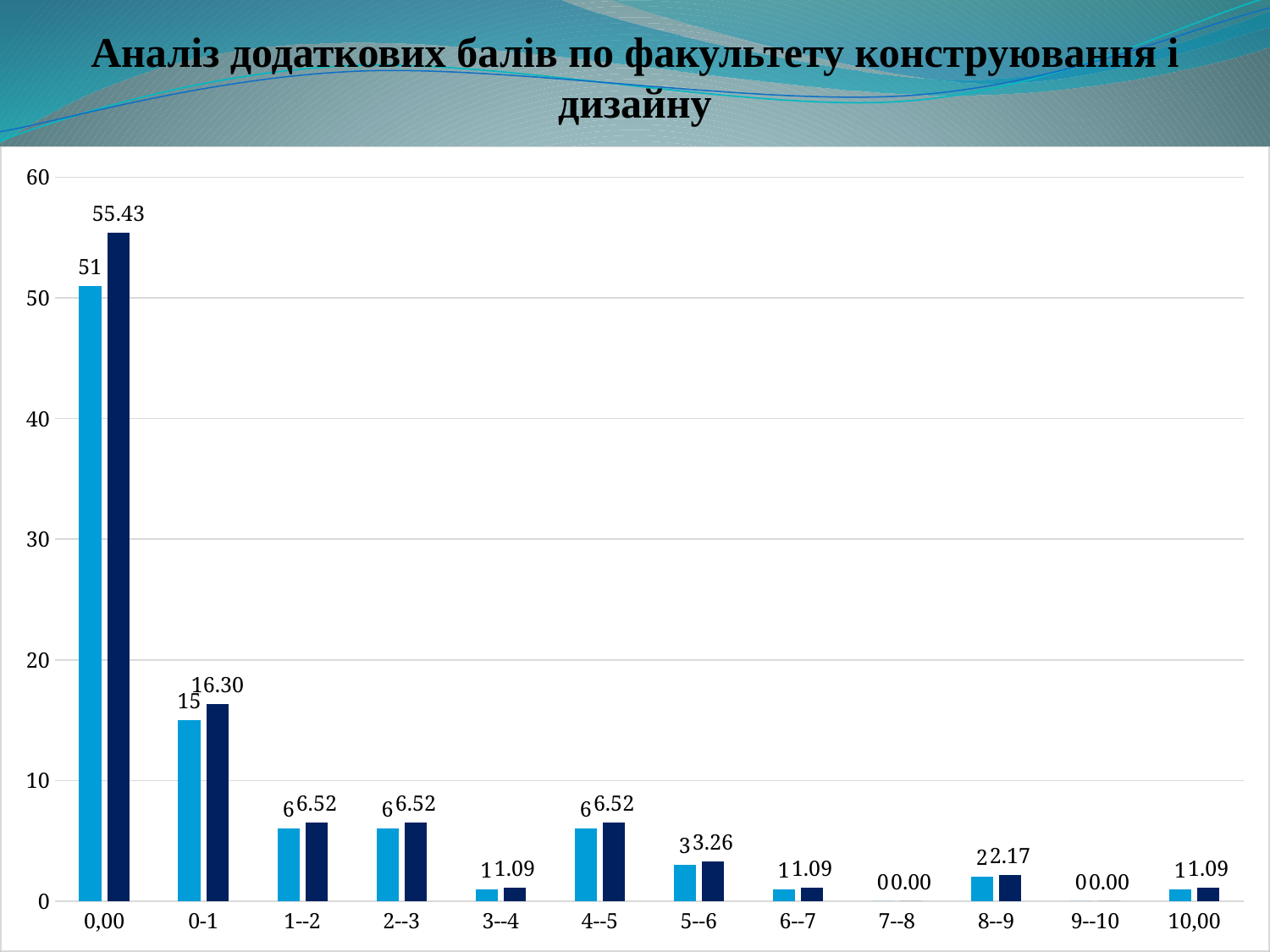
How many categories are shown on the x axis? 12 What is the value of the dark blue bar for the category 8--9? 2.17 What is the title of the chart on the slide? Аналіз додаткових балів по факультету конструювання і дизайну Which is larger: the light blue bar for 1--2 or the light blue bar for 5--6? 1--2 What is the value of the dark blue bar for the category 0,00? 55.43 What is the value of the light blue bar for the category 0,00? 51 What kind of chart is shown on the slide? bar chart Which category has the highest light blue bar? 0,00 Is the dark blue bar for 0-1 greater or less than 20? less What is the difference between the light blue bar values for 0,00 and 0-1? 36 What is the value of the dark blue bar for the category 0-1? 16.30 What is the value of the light blue bar for the category 5--6? 3